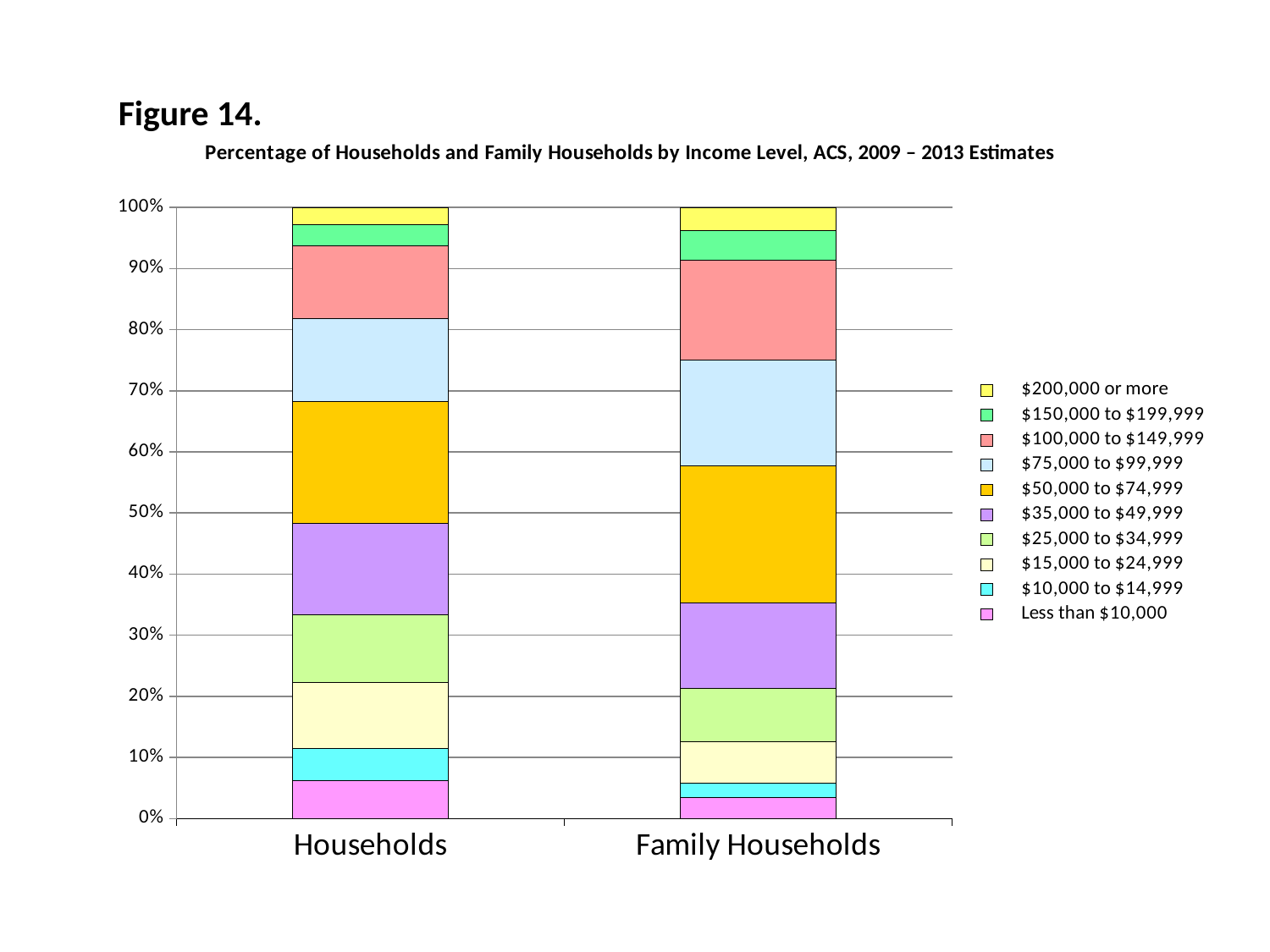
What kind of chart is shown on the slide? Stacked bar chart Which income level is the largest segment of the Households bar? $50,000 to $74,999 Which legend entry is shown at the top of the legend? $200,000 or more Is the value for Less than $10,000 in Households greater or less than 10%? less How many series does the legend list? 10 What is the total height of the Households bar? 100% Is the value for Less than $10,000 in Family Households greater or less than 10%? less What is the title of the chart? Percentage of Households and Family Households by Income Level, ACS, 2009 – 2013 Estimates Is the $100,000 to $149,999 segment larger for Households or for Family Households? Family Households Is the $15,000 to $24,999 segment larger for Households or for Family Households? Households Which income level is the largest segment of the Family Households bar? $50,000 to $74,999 How many categories are shown on the x axis? 2